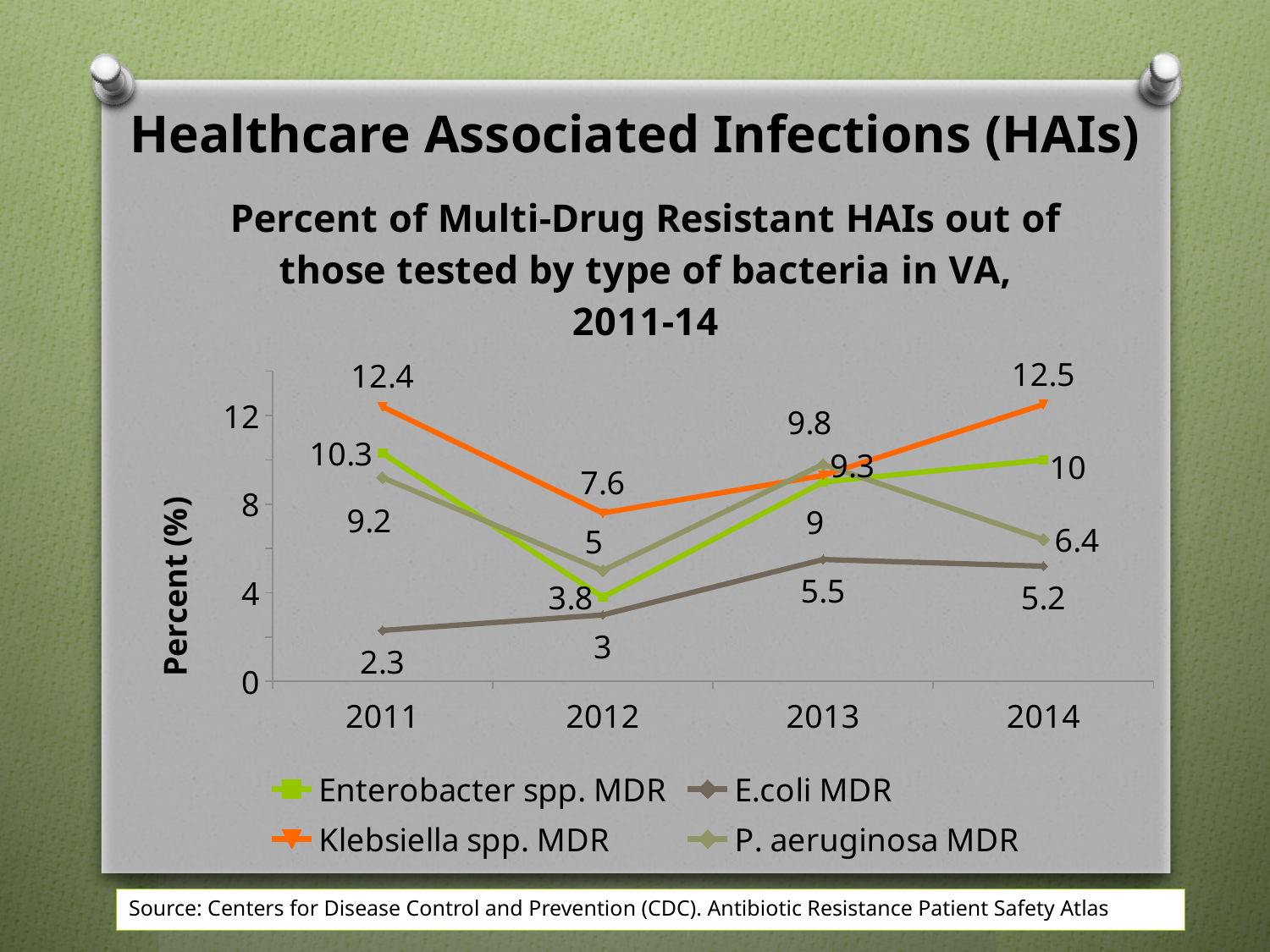
How many years are plotted along the x axis? 4 What is the difference between the Klebsiella spp. MDR values in 2014 and 2012? 4.9 In 2011, which is larger: Enterobacter spp. MDR or P. aeruginosa MDR? Enterobacter spp. MDR What is the value for E.coli MDR in 2014? 5.2 In which year is Klebsiella spp. MDR at its highest? 2014 What is the value for Klebsiella spp. MDR in 2011? 12.4 In which year is E.coli MDR at its lowest? 2011 What is the title of the vertical axis? Percent (%) Does the E.coli MDR line rise or fall from 2011 to 2013? Rise How many series does the legend list? 4 What kind of chart is shown on the slide? Line chart What is the value for P. aeruginosa MDR in 2013? 9.8